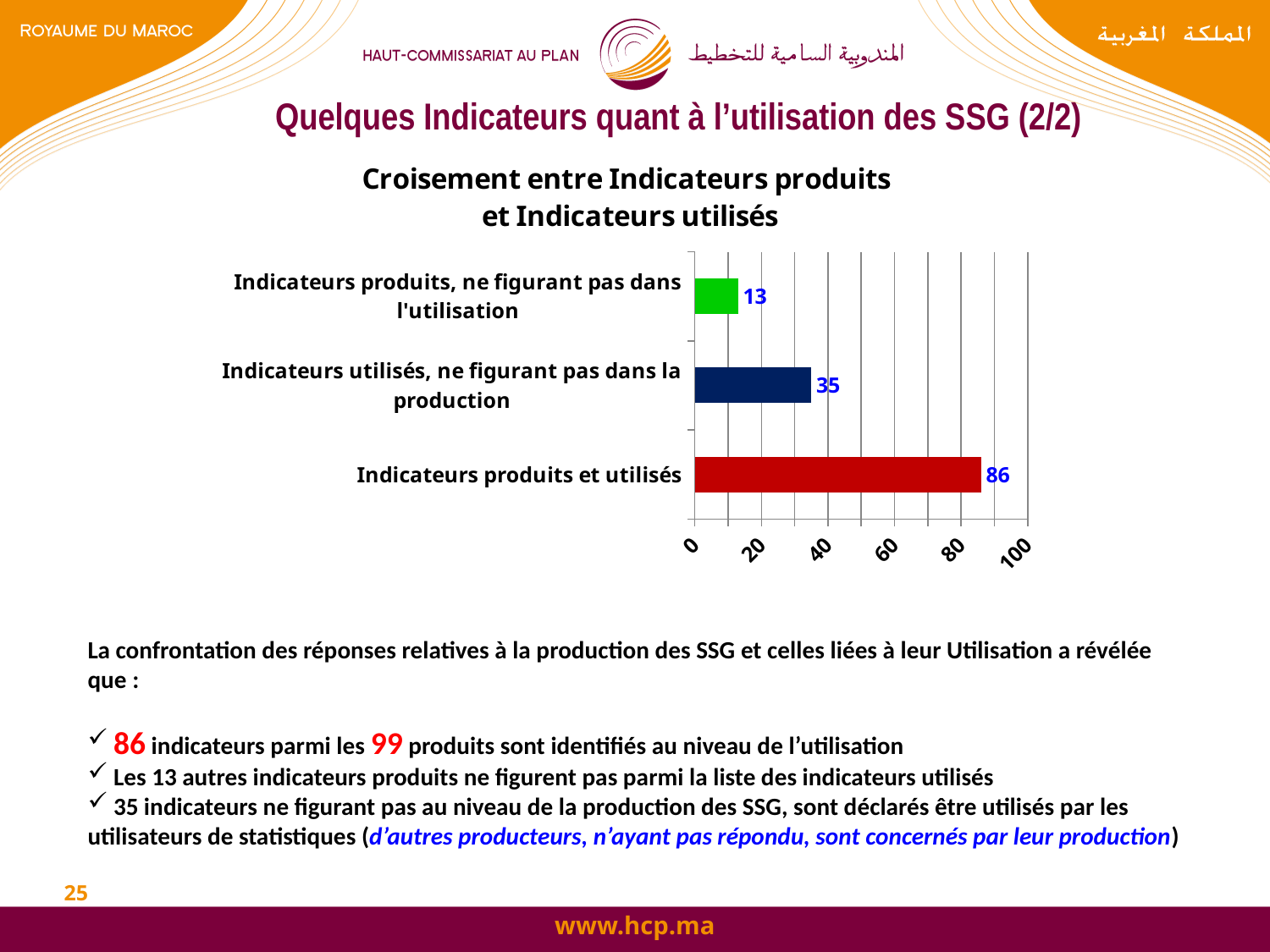
What kind of chart is shown on the slide? Bar chart Is the value for "Indicateurs produits et utilisés" greater or less than 80? greater What is the value for "Indicateurs produits et utilisés"? 86 What is the difference between the values for "Indicateurs utilisés, ne figurant pas dans la production" and "Indicateurs produits, ne figurant pas dans l'utilisation"? 22 What is the value for "Indicateurs utilisés, ne figurant pas dans la production"? 35 What is the value for "Indicateurs produits, ne figurant pas dans l'utilisation"? 13 What is the difference between the values for "Indicateurs produits et utilisés" and "Indicateurs utilisés, ne figurant pas dans la production"? 51 What is the title of the chart? Croisement entre Indicateurs produits et Indicateurs utilisés Which category has the highest value? Indicateurs produits et utilisés Which category has the lowest value? Indicateurs produits, ne figurant pas dans l'utilisation How many categories are shown in the chart? 3 Which is larger: the value for "Indicateurs utilisés, ne figurant pas dans la production" or for "Indicateurs produits, ne figurant pas dans l'utilisation"? Indicateurs utilisés, ne figurant pas dans la production